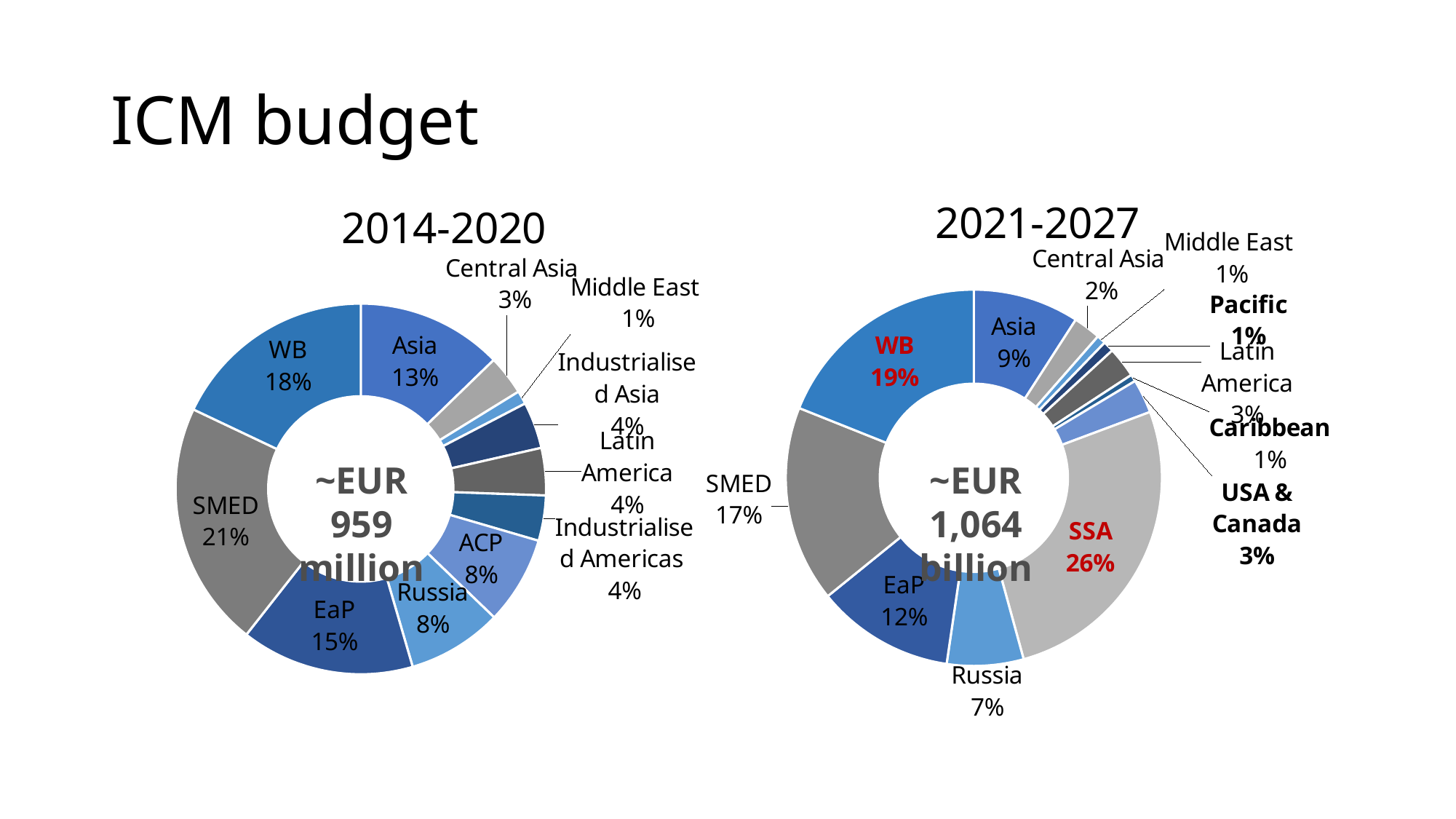
In the 2021-2027 chart, which category has the largest share? SSA In the 2021-2027 chart, what is the difference between the shares for WB and Russia? 12% In the 2014-2020 chart, which category has the largest share? SMED In the 2014-2020 chart, what share of the budget goes to SMED? 21% In the 2014-2020 chart, what is the difference between the shares for SMED and WB? 3% In the 2021-2027 chart, what share of the budget goes to SSA? 26% What kind of chart is the 2021-2027 chart? Doughnut (pie) chart In the 2014-2020 chart, which category has the smallest share? Middle East In the 2021-2027 chart, what share of the budget goes to EaP? 12% In the 2021-2027 chart, which is larger, the share for Asia or the share for SMED? SMED What total budget is shown in the centre of the 2021-2027 chart? ~EUR 1,064 billion How many categories are shown in the 2014-2020 chart? 11